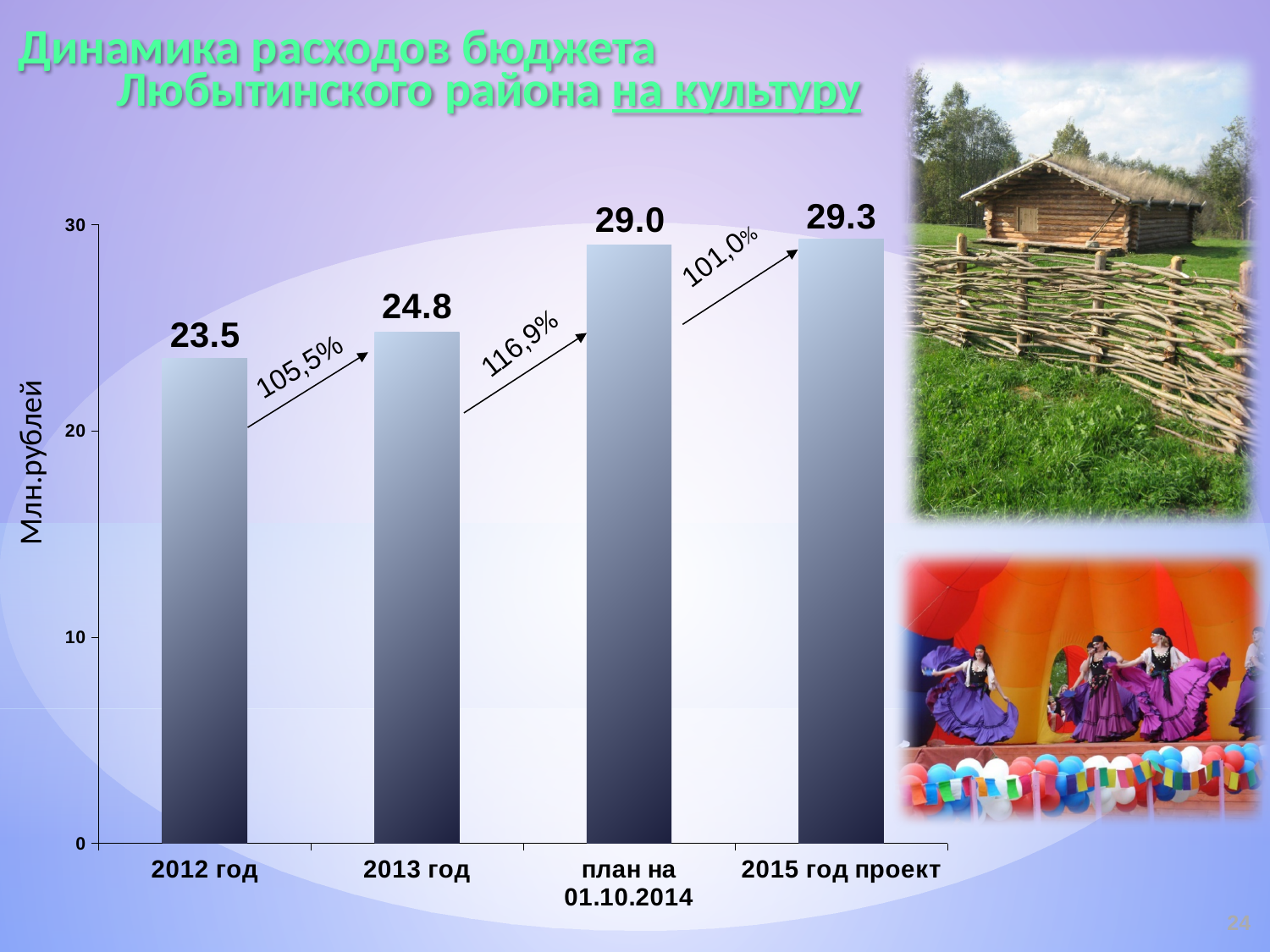
Which category has the lowest value? 2012 год What is the label on the vertical axis? Млн.рублей What kind of chart is shown on the slide? bar chart What is the value for 2012 год? 23.5 Do the values rise or fall from 2012 год to 2015 год проект? rise How many categories are shown on the x axis? 4 Which is larger, the value for 2013 год or the value for план на 01.10.2014? план на 01.10.2014 What is the value for 2013 год? 24.8 Which category has the highest value? 2015 год проект What is the difference between the values for 2013 год and 2012 год? 1.3 What is the value for 2015 год проект? 29.3 What is the value for план на 01.10.2014? 29.0